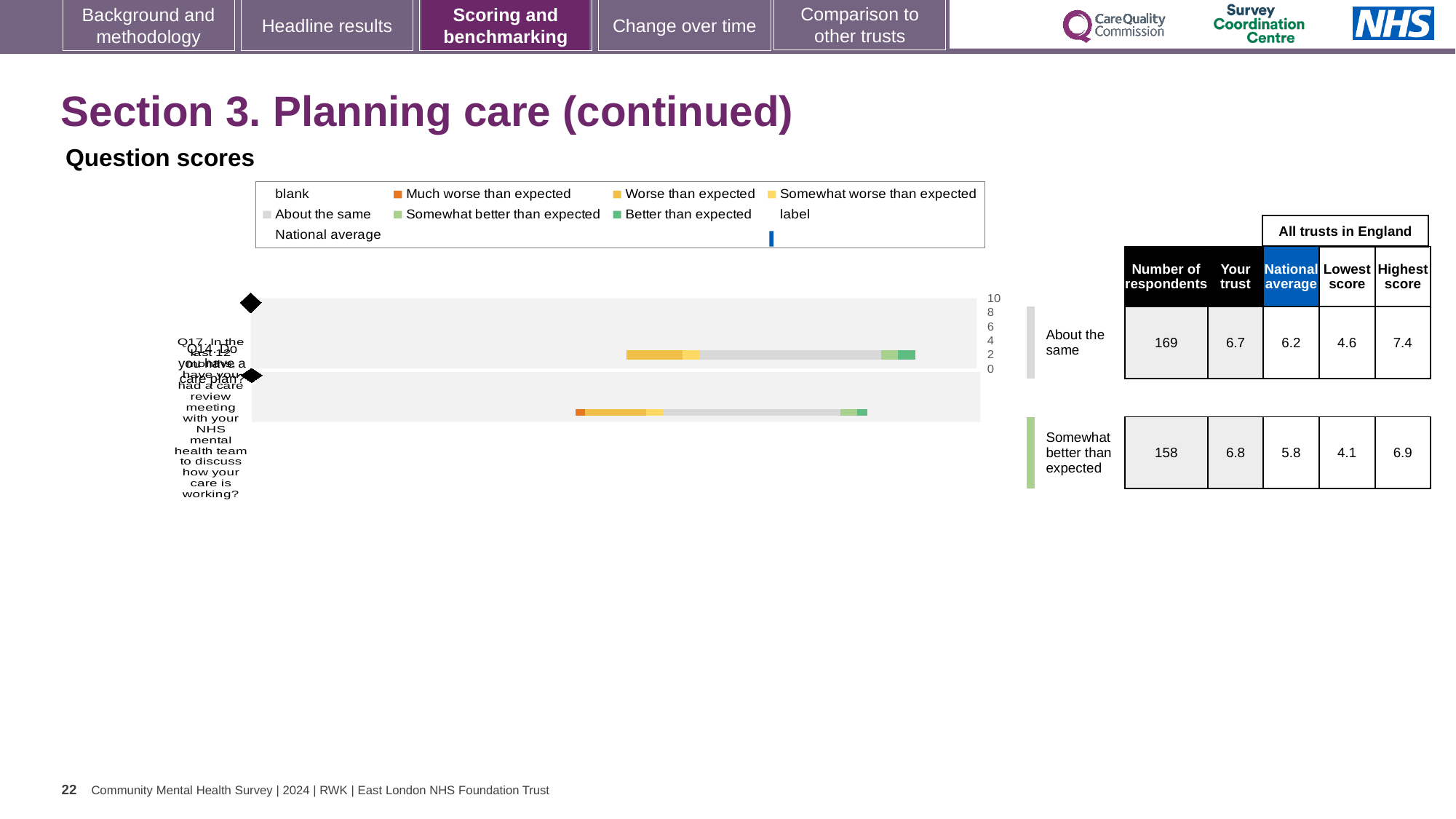
In the table beside the chart, which is larger for the first row: the 'Your trust' score or the national average? Your trust How many bars (question rows) are plotted in the chart? 2 In the table beside the chart, what is the number of respondents for the first row (About the same)? 169 In the table beside the chart, which row has the higher number of respondents? About the same In the table beside the chart, what is the 'Your trust' score for the first row (About the same)? 6.7 In the table beside the chart, what is the number of respondents for the second row (Somewhat better than expected)? 158 What is the highest value shown on the chart's axis? 10 In the table beside the chart, what is the national average for the second row (Somewhat better than expected)? 5.8 In the table beside the chart, what is the difference between the 'Your trust' score and the national average for the second row (Somewhat better than expected)? 1.0 What kind of chart is shown on the slide? bar chart In the table beside the chart, what is the highest score among all trusts in England for the first row (About the same)? 7.4 In the table beside the chart, what is the lowest score among all trusts in England for the second row (Somewhat better than expected)? 4.1